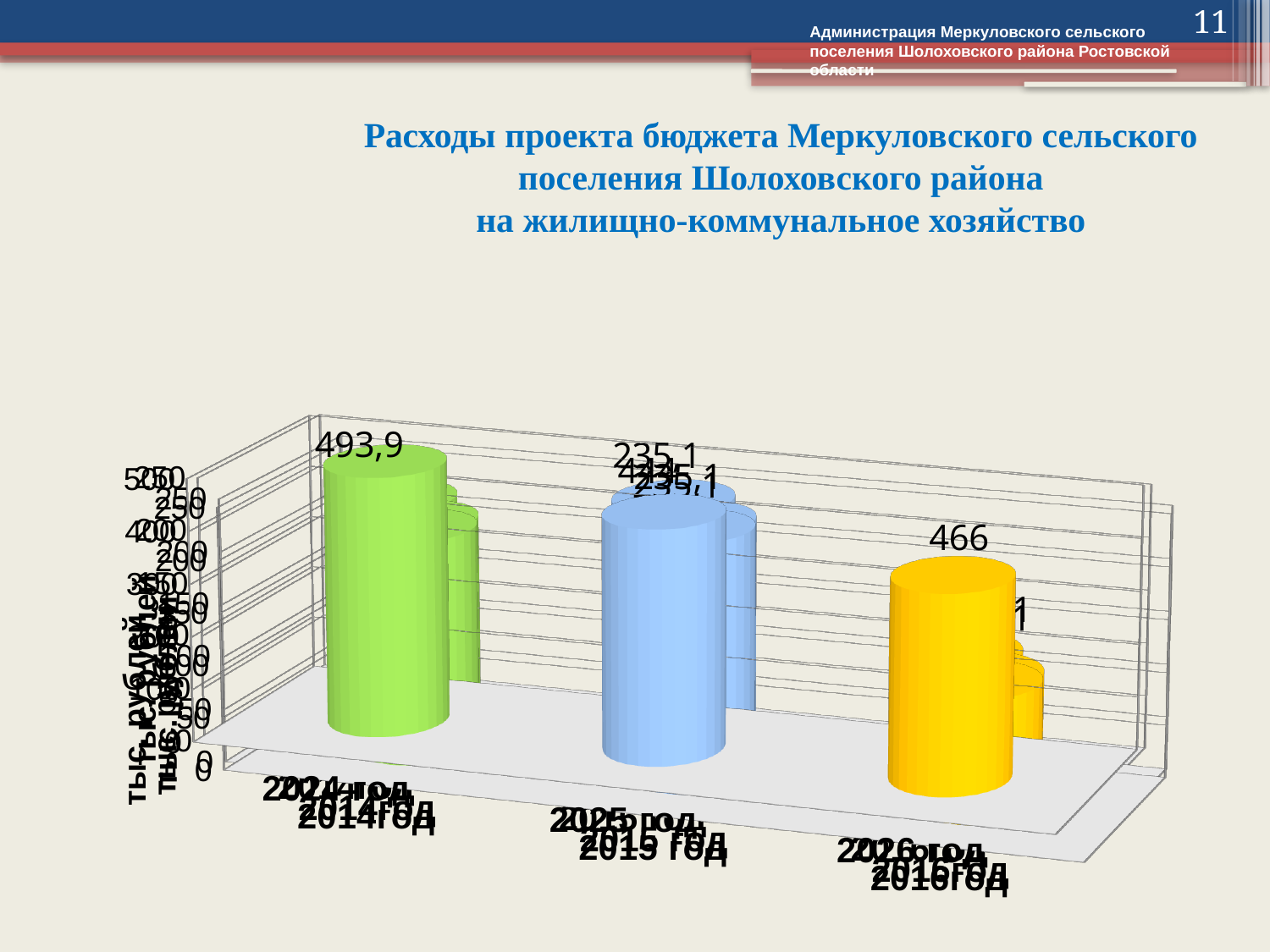
Which is larger, the value of the green bar (493,9) or the yellow bar (466)? green bar (493,9) What is the unit shown on the vertical axis title? тыс. рублей What kind of chart is shown on the slide? bar chart What is the difference between the green bar (493,9) and the yellow bar (466)? 27,9 What colours are the three bars, from left to right? green, blue, yellow How many bars are plotted in the front chart? 3 What is the value printed above the green (first) bar? 493,9 What is the value printed above the yellow (third) bar? 466